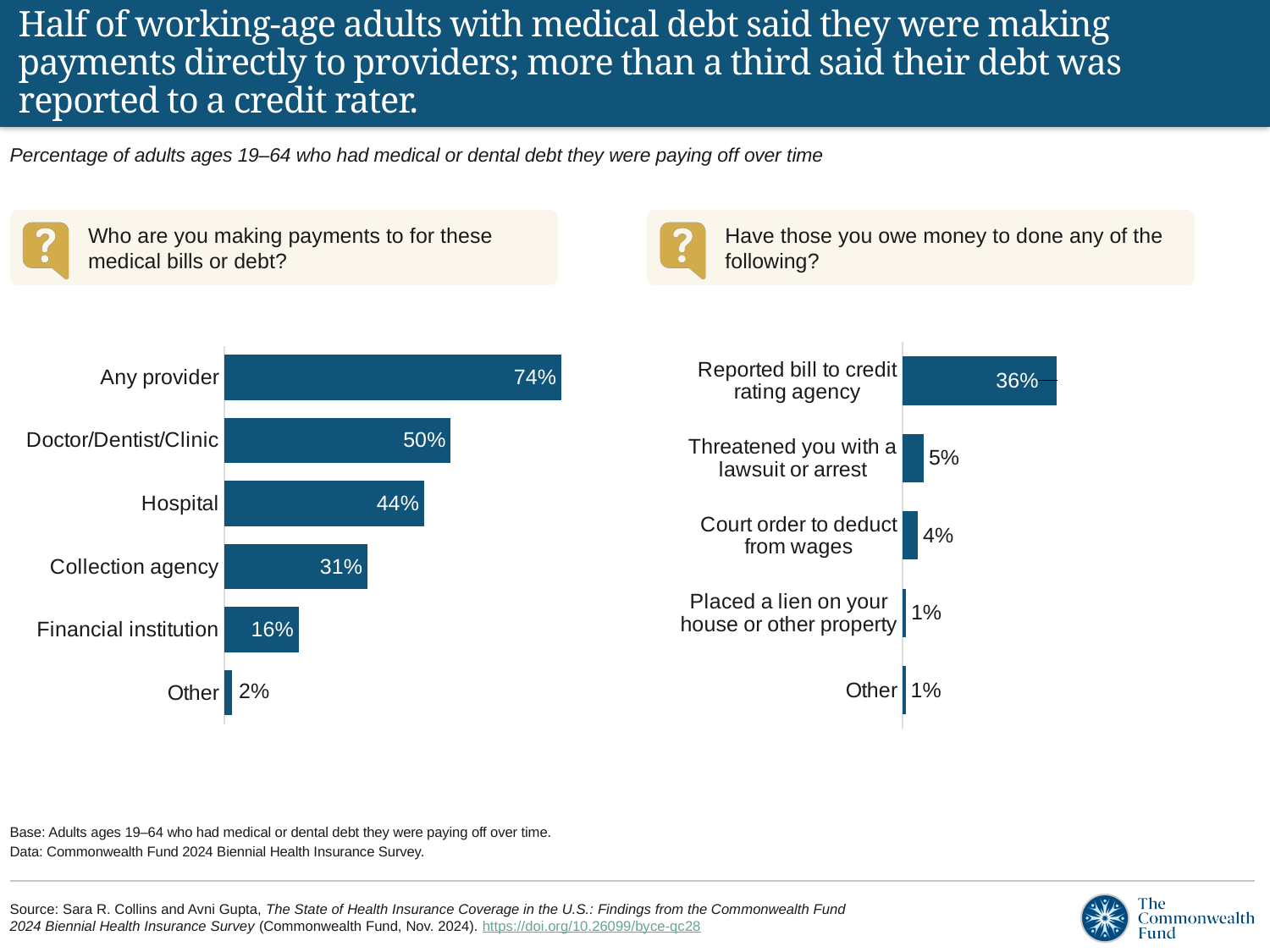
In the left chart (Who are you making payments to for these medical bills or debt?), what is the difference between the values for Doctor/Dentist/Clinic and Financial institution? 34 percentage points In the left chart (Who are you making payments to for these medical bills or debt?), what percentage of adults said they were making payments to a hospital? 44% In the left chart (Who are you making payments to for these medical bills or debt?), which category has the lowest value? Other In the left chart (Who are you making payments to for these medical bills or debt?), which category has the highest value? Any provider In the right chart (Have those you owe money to done any of the following?), what is the difference between Reported bill to credit rating agency and Threatened you with a lawsuit or arrest? 31 percentage points What type of chart is used on the right side of the slide (Have those you owe money to done any of the following?)? Bar chart In the right chart (Have those you owe money to done any of the following?), what percentage said the bill was reported to a credit rating agency? 36% In the right chart (Have those you owe money to done any of the following?), which category has the highest value? Reported bill to credit rating agency In the left chart (Who are you making payments to for these medical bills or debt?), what is the value for Collection agency? 31% How many categories are shown in the left chart (Who are you making payments to for these medical bills or debt?)? 6 In the left chart (Who are you making payments to for these medical bills or debt?), which is larger: the value for Hospital or the value for Collection agency? Hospital In the right chart (Have those you owe money to done any of the following?), what is the value for Court order to deduct from wages? 4%